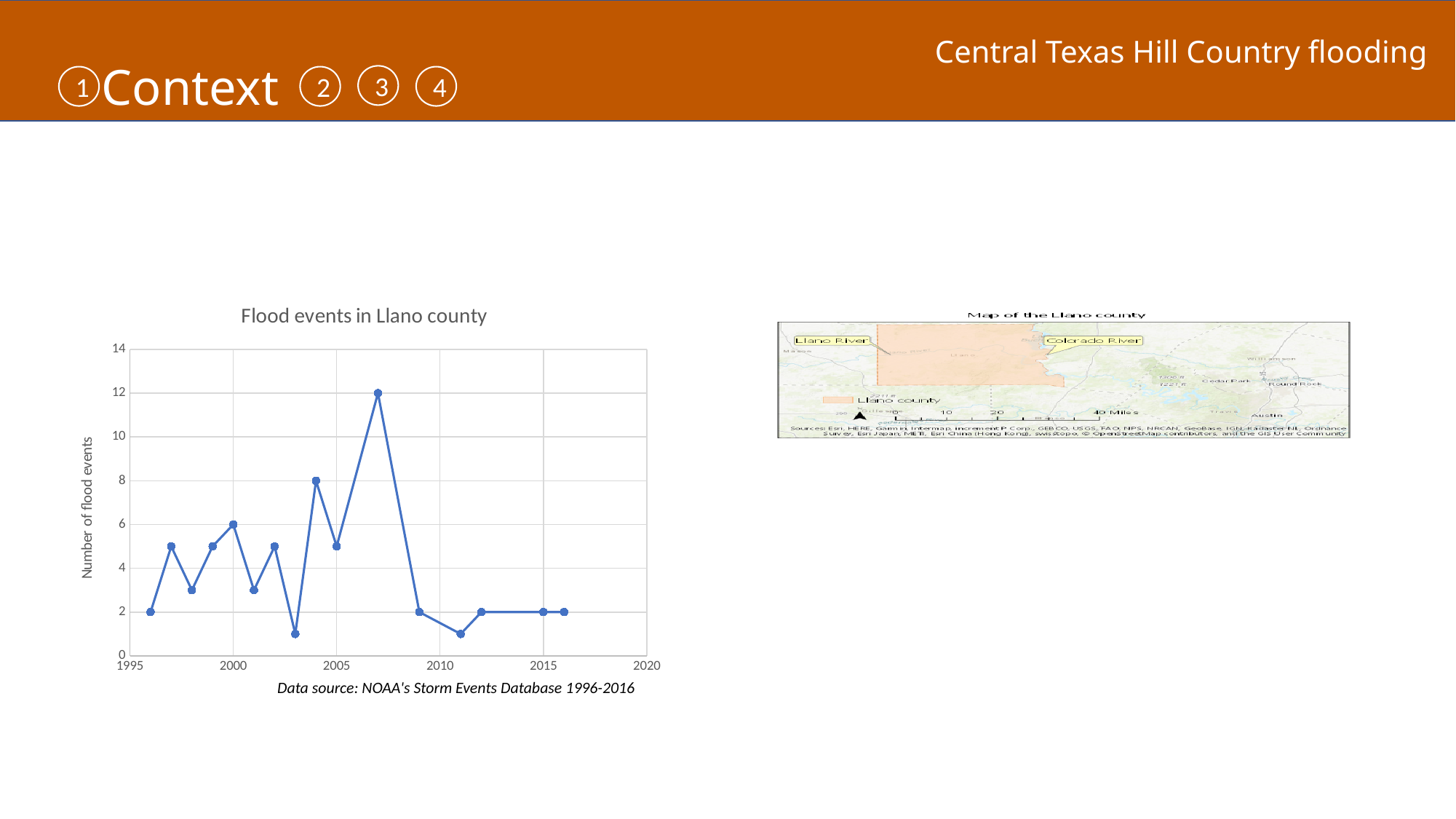
In the "Flood events in Llano county" chart, is the value for 2005 greater or less than 4? greater In the "Flood events in Llano county" chart, what is the number of flood events in 2015? 2 In the "Flood events in Llano county" chart, what is the difference between the number of flood events in 2000 and in 2015? 4 In the "Flood events in Llano county" chart, what is the number of flood events in 2000? 6 What is the title of the chart on the left of the slide? Flood events in Llano county In the "Flood events in Llano county" chart, does the number of flood events rise or fall between the peak around 2007 and 2010? fall What kind of chart is "Flood events in Llano county"? line chart In the "Flood events in Llano county" chart, which year has more flood events, 2000 or 2015? 2000 In the "Flood events in Llano county" chart, what is the highest number of flood events reached by the line? 12 What is the label on the vertical axis of the "Flood events in Llano county" chart? Number of flood events How many data points are plotted in the "Flood events in Llano county" chart? 16 In the "Flood events in Llano county" chart, is the value for 2005 greater or less than 6? less